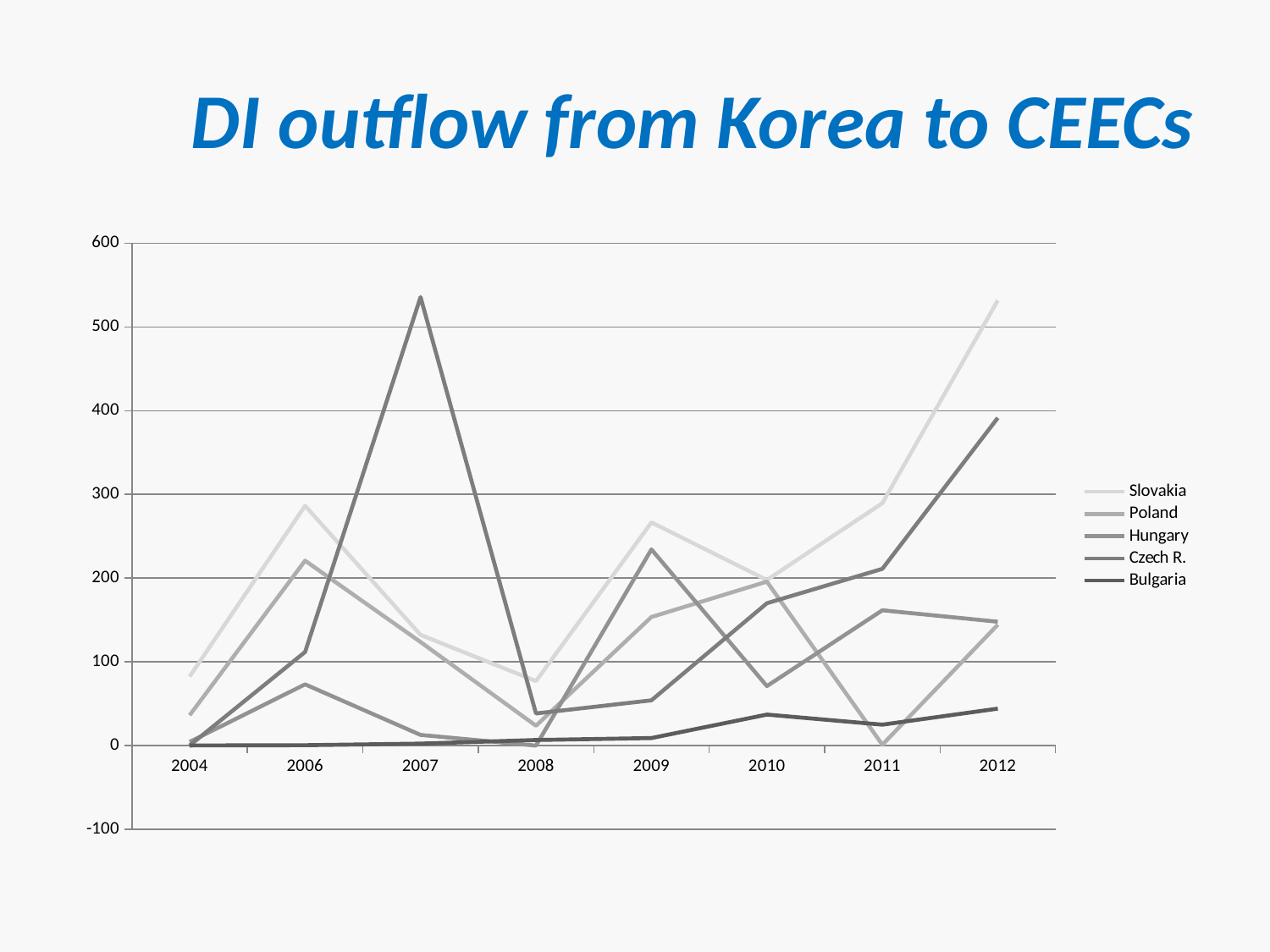
How many years are shown along the x axis? 8 Which country has the lowest value in 2012? Bulgaria Is the value for Bulgaria in 2012 greater or less than 100? less Is the value for Czech R. in 2007 greater or less than 500? greater What is the title of the chart on the slide? DI outflow from Korea to CEECs Does the value for Slovakia rise or fall from 2010 to 2012? rise What kind of chart is shown on the slide? line chart How many series does the legend list? 5 Which country has the highest value in 2012? Slovakia Which country has the highest value in 2007? Czech R. In 2006, which is larger: the value for Slovakia or the value for Bulgaria? Slovakia Is the value for Slovakia in 2012 greater or less than 500? greater